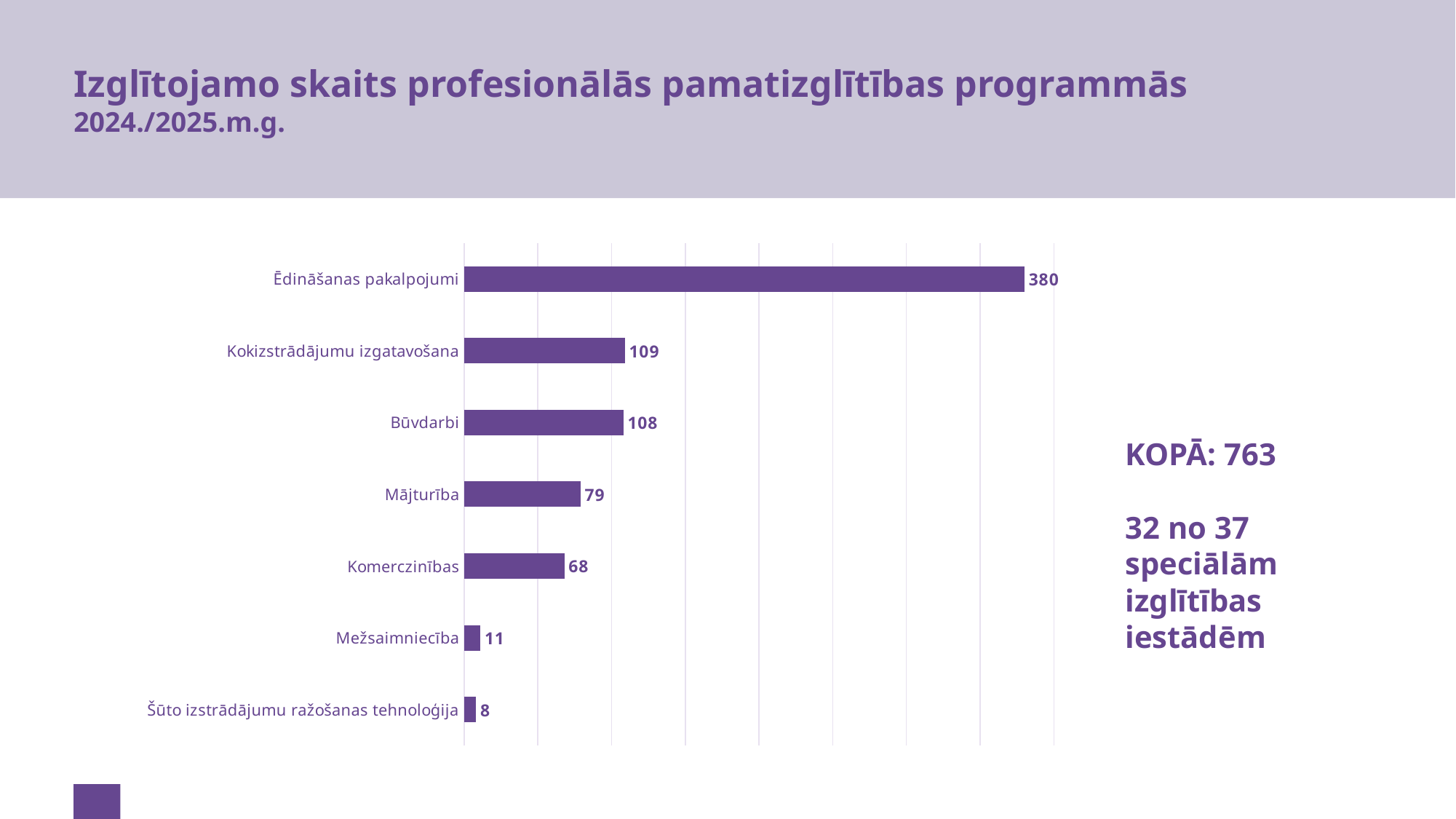
Which is larger, the value for Mājturība or the value for Komerczinības? Mājturība What is the difference between the values for Ēdināšanas pakalpojumi and Kokizstrādājumu izgatavošana? 271 How many categories are shown in the chart? 7 What is the value for Komerczinības? 68 What is the difference between the values for Mājturība and Komerczinības? 11 Which category has the lowest value? Šūto izstrādājumu ražošanas tehnoloģija What is the value for Būvdarbi? 108 What is the value for Ēdināšanas pakalpojumi? 380 Which category has the highest value? Ēdināšanas pakalpojumi What total (KOPĀ) is stated next to the chart? 763 What kind of chart is shown on the slide? bar chart What is the value for Mežsaimniecība? 11